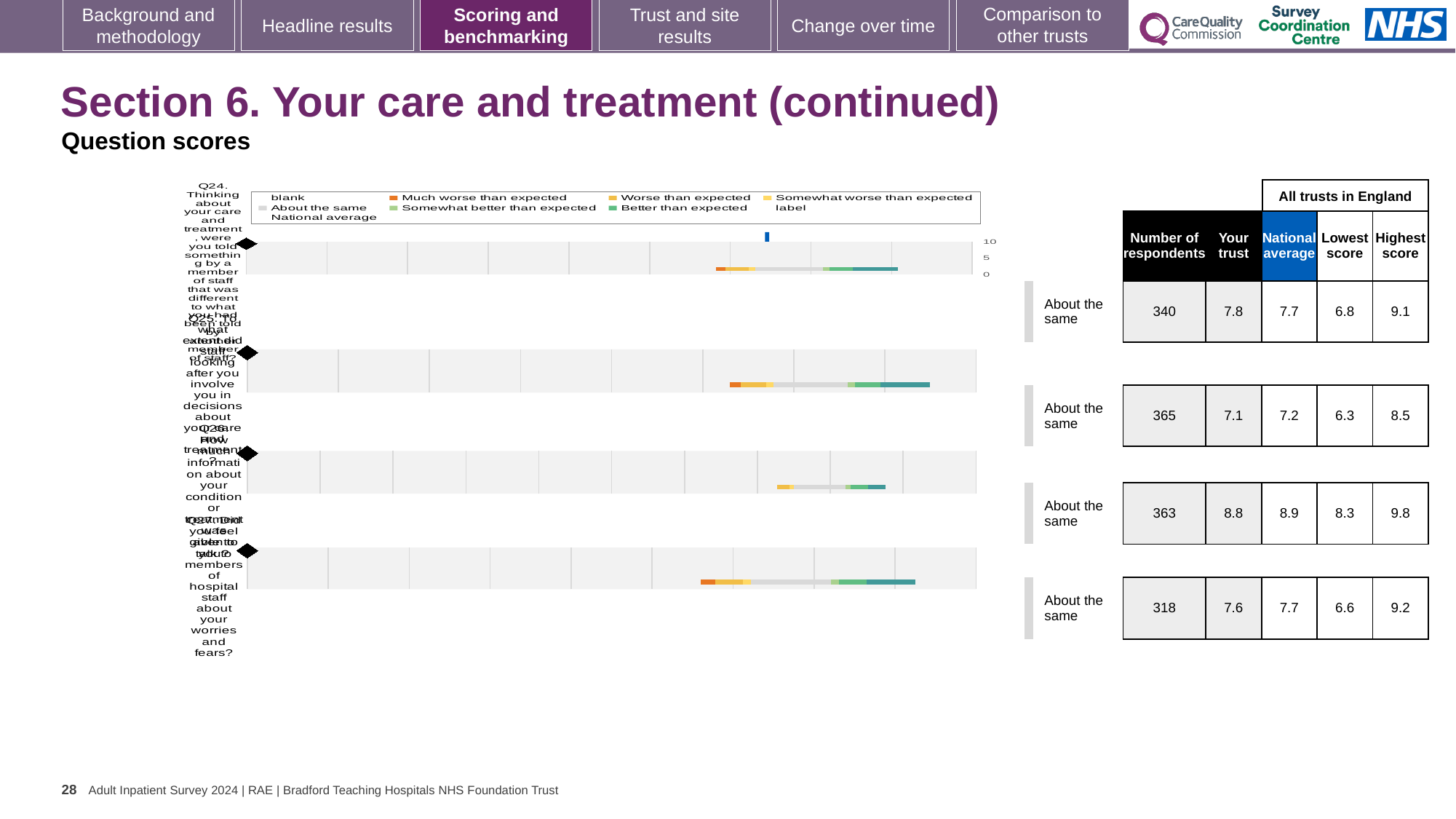
Which question chart has the highest 'Your trust' score: Q24, Q25, Q26 or Q27? Q26 What kind of chart is used for each question on this slide? bar chart For the Q26 chart (third chart), what is the highest score across all trusts in England? 9.8 For the Q25 chart (second chart), what is the difference between the highest score (8.5) and the lowest score (6.3)? 2.2 How many question charts are shown on the slide? 4 In the chart legend, what colour represents 'About the same'? grey For the Q24 chart (first chart), what is the 'Your trust' score in the table? 7.8 For the Q24 chart (first chart), what benchmark category is shown next to it? About the same In the chart legend, what colour represents 'Much worse than expected'? orange For the Q25 chart (second chart), what is the number of respondents? 365 Which question chart has the lowest number of respondents: Q24, Q25, Q26 or Q27? Q27 For the Q27 chart (fourth chart), what is the national average score? 7.7